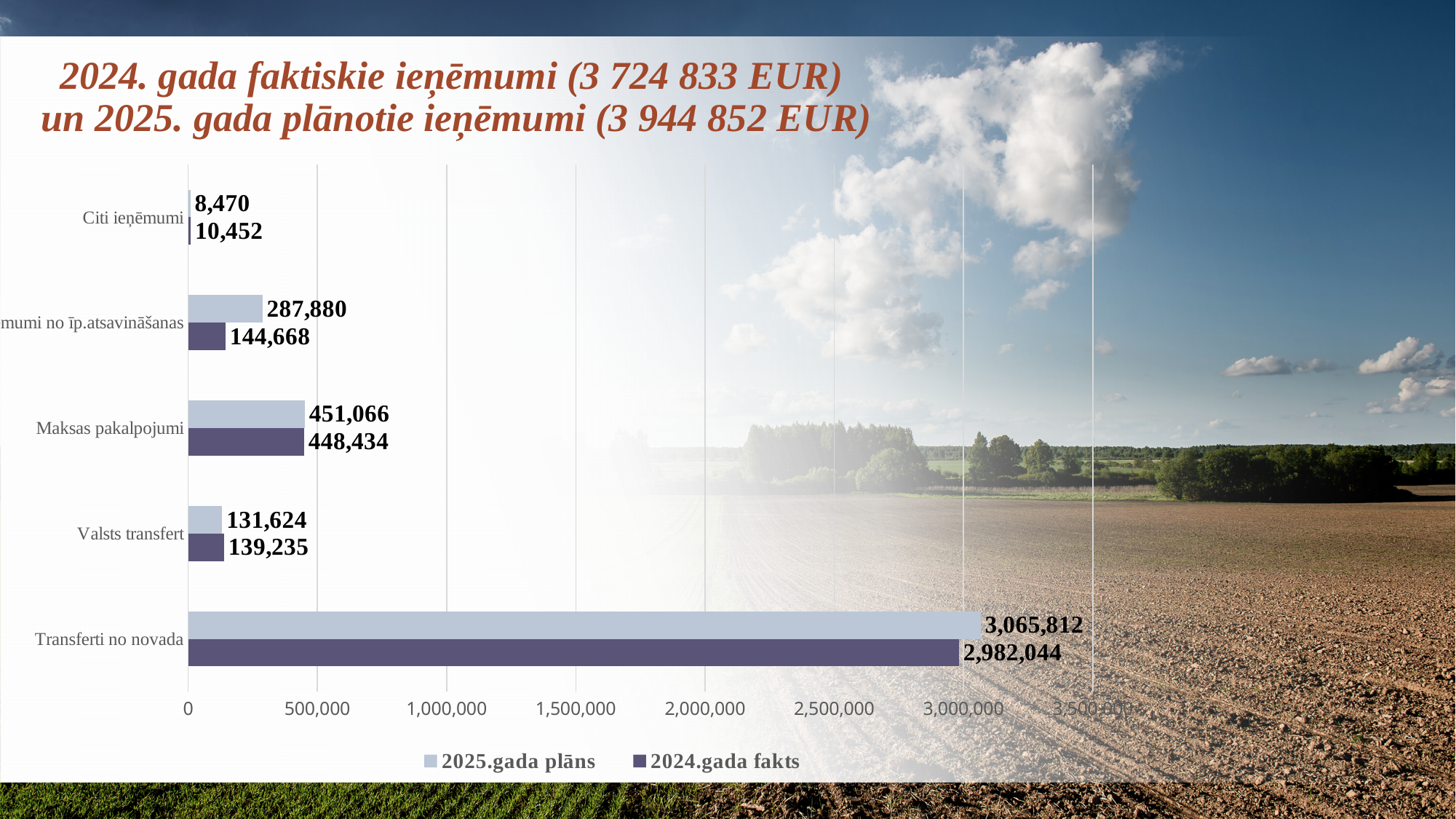
For Maksas pakalpojumi, which series has the larger value, 2025.gada plāns or 2024.gada fakts? 2025.gada plāns Which category has the lowest 2025.gada plāns value? Citi ieņēmumi What is the 2025.gada plāns value for Valsts transfert? 131,624 What kind of chart is shown on the slide? Bar chart What is the 2024.gada fakts value for Maksas pakalpojumi? 448,434 How many series does the legend list? 2 What is the difference between the 2024.gada fakts and 2025.gada plāns values for Valsts transfert? 7,611 How much larger is the 2025.gada plāns value than the 2024.gada fakts value for Transferti no novada? 83,768 Which category has the highest 2024.gada fakts value? Transferti no novada What is the 2025.gada plāns value for Transferti no novada? 3,065,812 What is the 2024.gada fakts value for Citi ieņēmumi? 10,452 How many categories are shown on the chart? 5